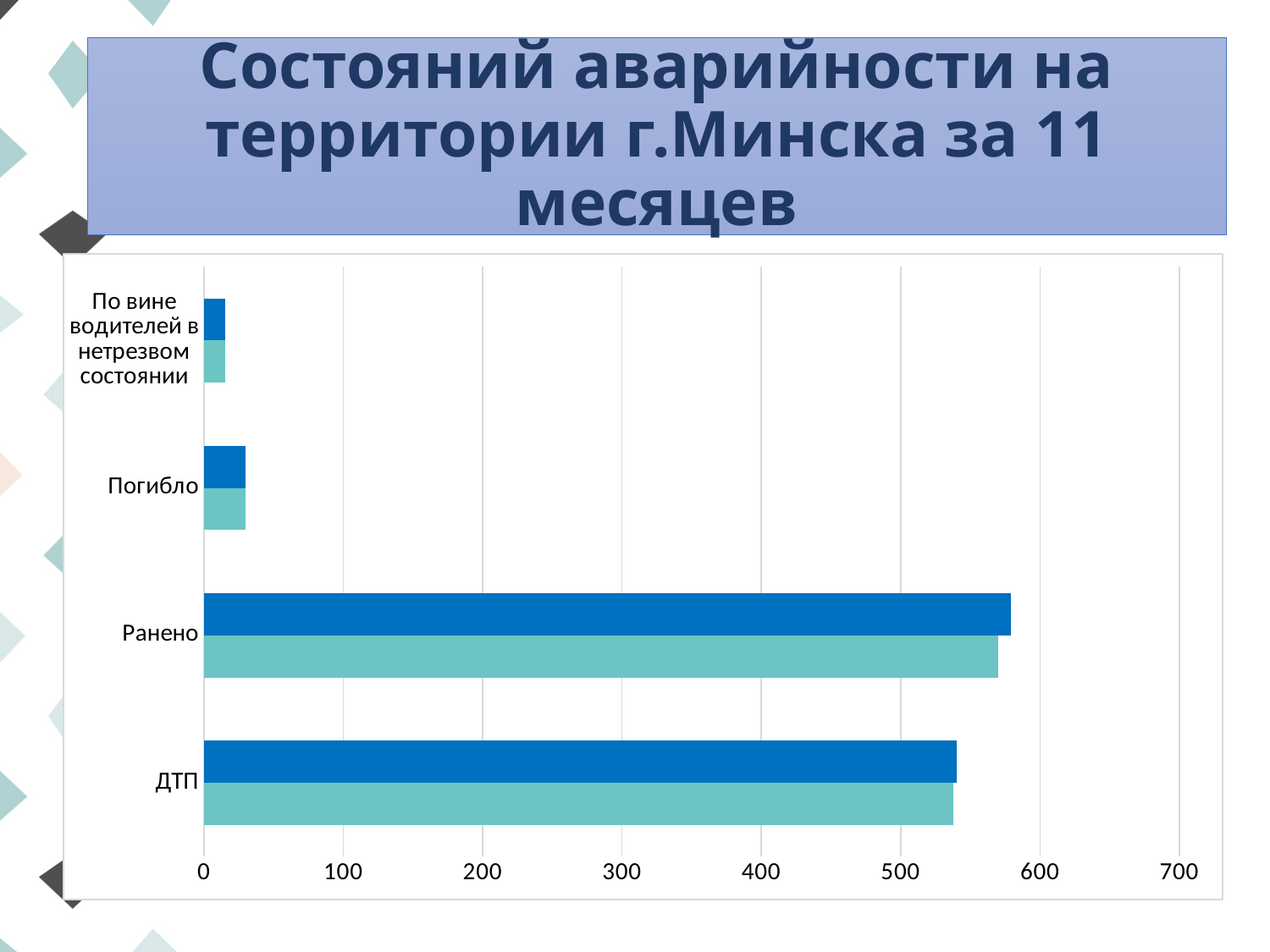
How many categories are shown on the chart? 4 Is the dark blue value for По вине водителей в нетрезвом состоянии greater or less than 100? less What kind of chart is shown on the slide? bar chart What is the title of the slide? Состояний аварийности на территории г.Минска за 11 месяцев Is the dark blue value for ДТП greater or less than 500? greater Which category has the longest light teal bar? Ранено Which has the larger dark blue value, Ранено or ДТП? Ранено Which category has the longest dark blue bar? Ранено Is the light teal value for Погибло greater or less than 100? less Which has the larger light teal value, Погибло or По вине водителей в нетрезвом состоянии? Погибло Which category has the shortest dark blue bar? По вине водителей в нетрезвом состоянии